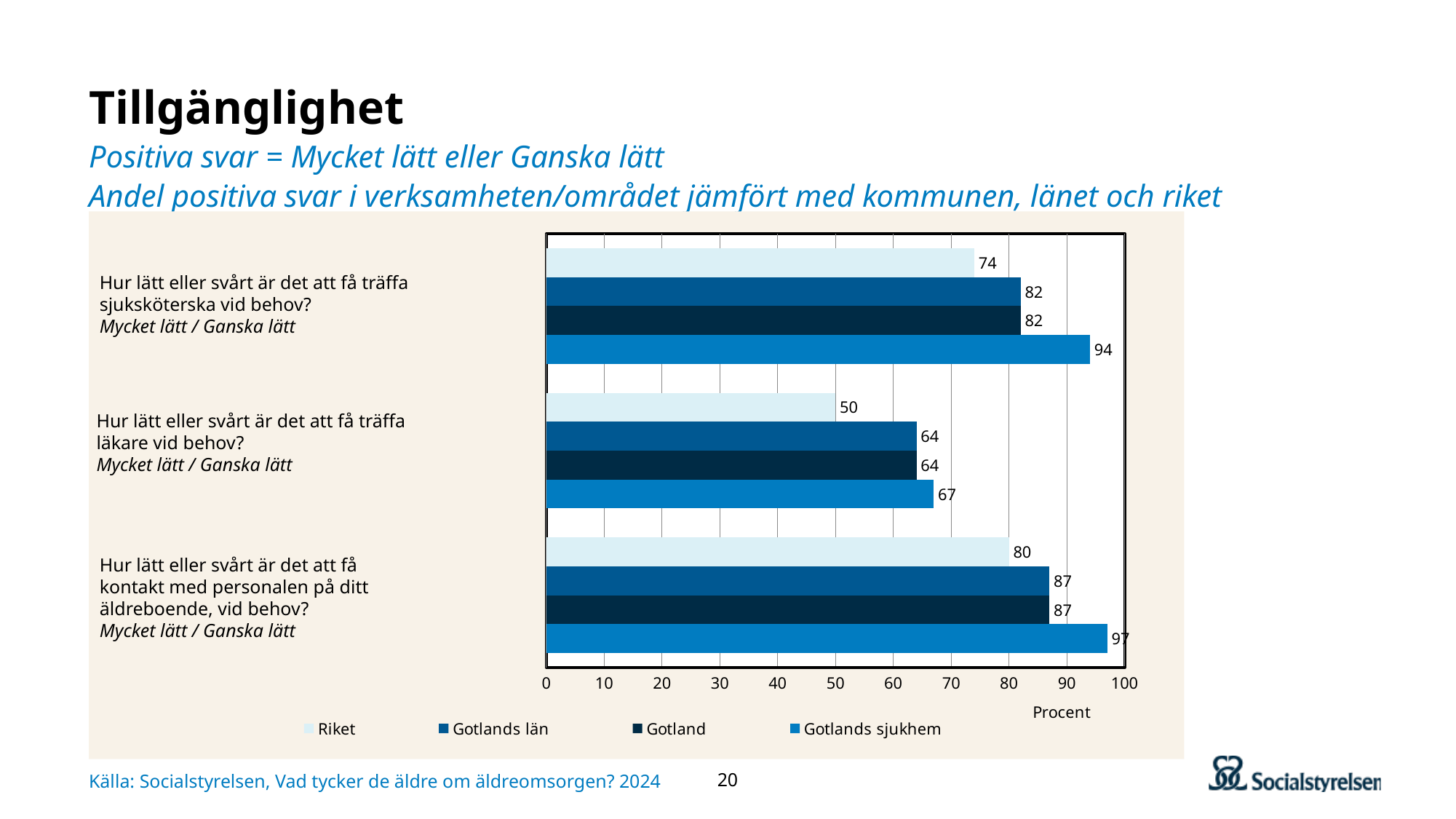
What is the value for Riket on the question about meeting a doctor when needed (träffa läkare vid behov)? 50 What is the label on the horizontal axis of the chart? Procent What is the value for Gotland on the question about meeting a doctor when needed (träffa läkare vid behov)? 64 Which series has the highest value on the question about meeting a doctor when needed (träffa läkare vid behov)? Gotlands sjukhem What is the value for Gotlands sjukhem on the question about meeting a nurse when needed (träffa sjuksköterska vid behov)? 94 What is the value for Gotlands län on the question about getting in contact with staff at the äldreboende? 87 How many questions (categories) are shown on the chart? 3 Which is larger: the Gotlands sjukhem value for meeting a doctor (träffa läkare) or the Gotlands sjukhem value for contacting staff at the äldreboende? Contacting staff at the äldreboende (97) How many series does the legend list? 4 What is the difference between Gotlands sjukhem and Riket on the question about meeting a nurse when needed (träffa sjuksköterska vid behov)? 20 Which series has the lowest value on the question about getting in contact with staff at the äldreboende? Riket What kind of chart is shown on the slide? Bar chart